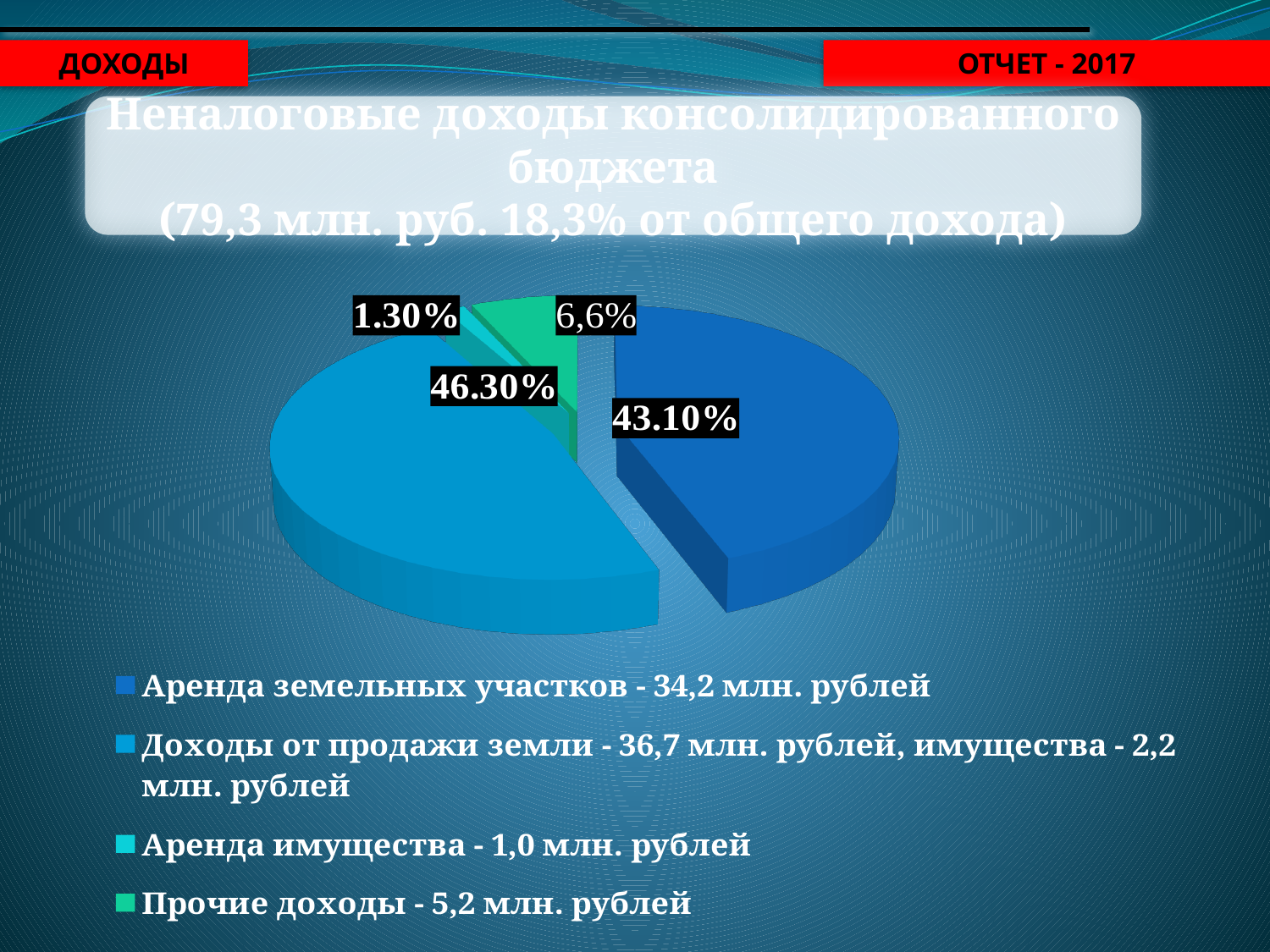
How many slices does the pie chart have? 4 What share of the pie does the slice for "Аренда земельных участков" represent? 43.10% What kind of chart is shown on the slide? pie chart What total amount of non-tax revenue is stated in the chart title? 79,3 млн. руб. Which category has the smallest slice of the pie? Аренда имущества What share of the pie does the slice for "Аренда имущества" represent? 1.30% Which category has the largest slice of the pie? Доходы от продажи земли, имущества How many entries does the legend list? 4 What share of the pie does the slice for "Доходы от продажи земли" and "имущества" represent? 46.30% According to the legend, what amount in млн. рублей is given for "Аренда земельных участков"? 34,2 млн. рублей Which slice is larger: "Прочие доходы" or "Аренда имущества"? Прочие доходы